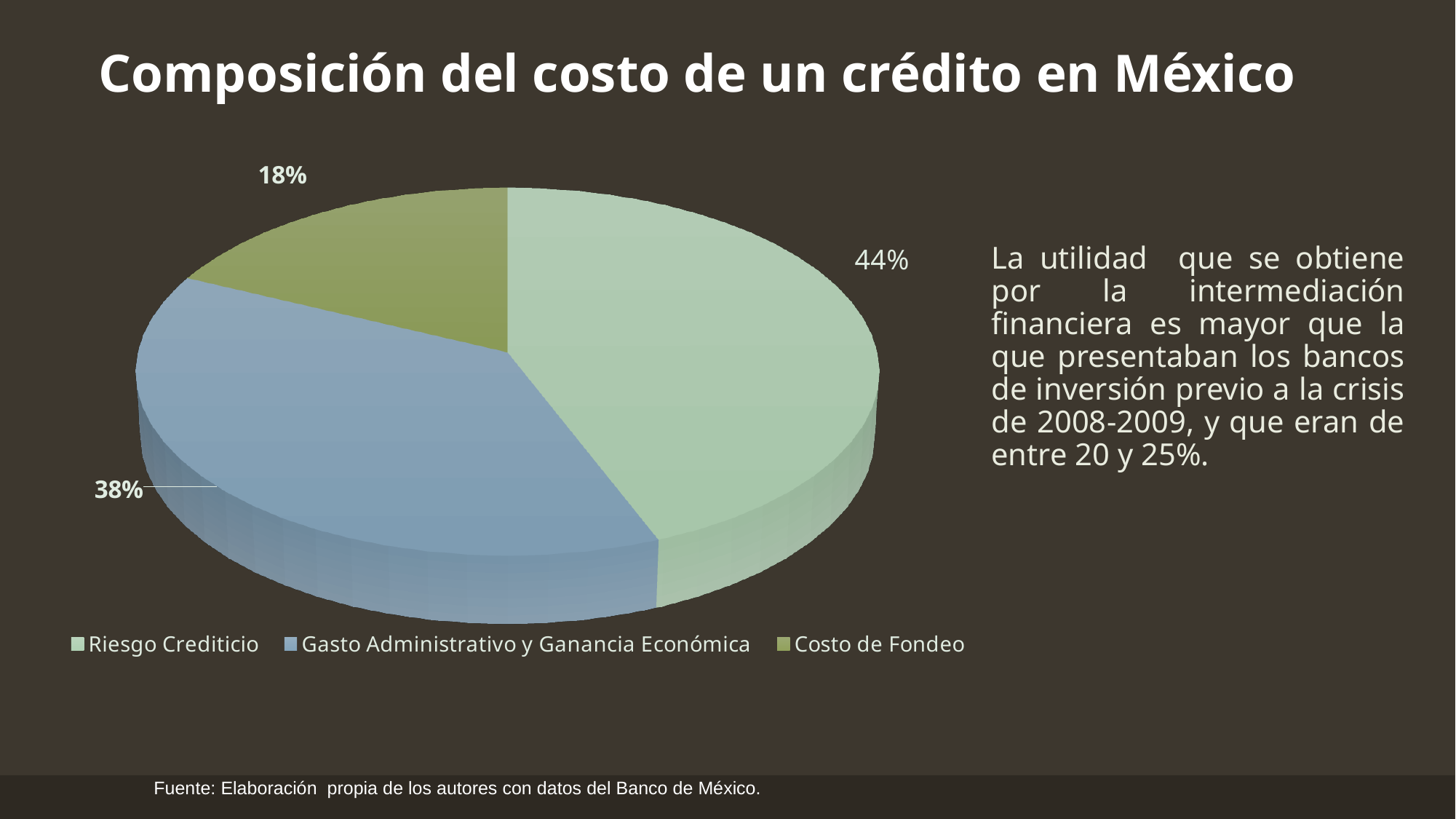
What is the title of the slide? Composición del costo de un crédito en México Which is larger, the slice for Gasto Administrativo y Ganancia Económica or the slice for Costo de Fondeo? Gasto Administrativo y Ganancia Económica Which legend entry is shown in blue? Gasto Administrativo y Ganancia Económica Which category has the largest slice of the pie? Riesgo Crediticio What share of the pie does Costo de Fondeo represent? 18% What share of the pie does Gasto Administrativo y Ganancia Económica represent? 38% How many slices does the pie chart have? 3 What is the difference in percentage points between Riesgo Crediticio and Costo de Fondeo? 26 What kind of chart is shown on the slide? Pie chart What share of the pie does Riesgo Crediticio represent? 44% Which category has the smallest slice of the pie? Costo de Fondeo What is the difference in percentage points between Riesgo Crediticio and Gasto Administrativo y Ganancia Económica? 6